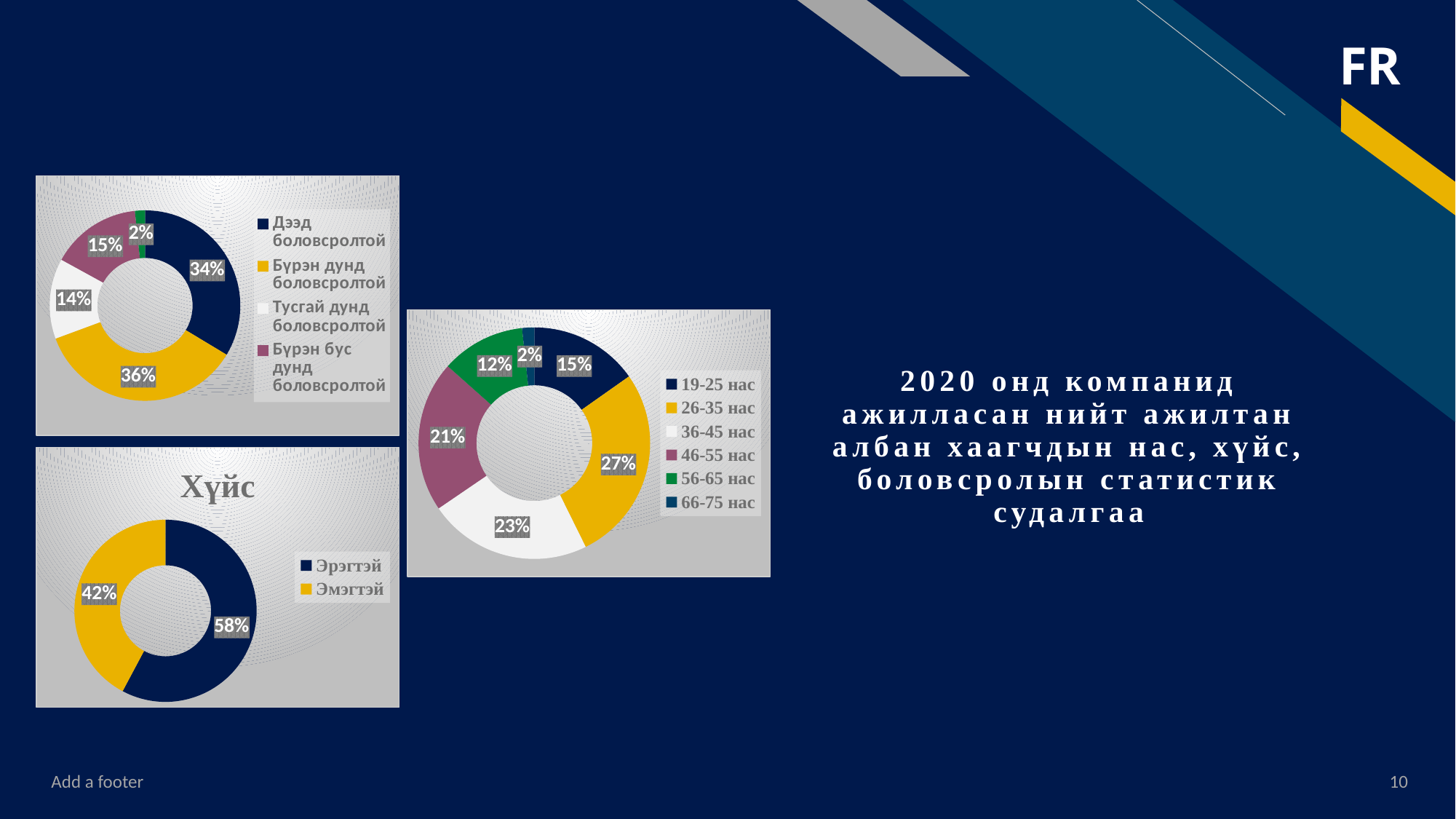
In the bottom-left chart titled 'Хүйс', what share is labelled for Эрэгтэй? 58% In the middle chart showing age groups, which age group has the largest share? 26-35 нас In the top-left chart, what share is labelled for Дээд боловсролтой? 34% In the middle chart showing age groups, what share is labelled for 46-55 нас? 21% In the middle chart showing age groups, which age group has the smallest share? 66-75 нас What type of chart is the bottom-left chart titled 'Хүйс'? Doughnut chart In the bottom-left chart titled 'Хүйс', what share is labelled for Эмэгтэй? 42% In the top-left chart, what share is labelled for Бүрэн дунд боловсролтой? 36% In the bottom-left chart titled 'Хүйс', what is the difference between the Эрэгтэй and Эмэгтэй shares? 16% In the top-left chart, which is larger: Тусгай дунд боловсролтой or Бүрэн бус дунд боловсролтой? Бүрэн бус дунд боловсролтой In the bottom-left chart titled 'Хүйс', how many series does the legend list? 2 In the middle chart showing age groups, how many age groups does the legend list? 6